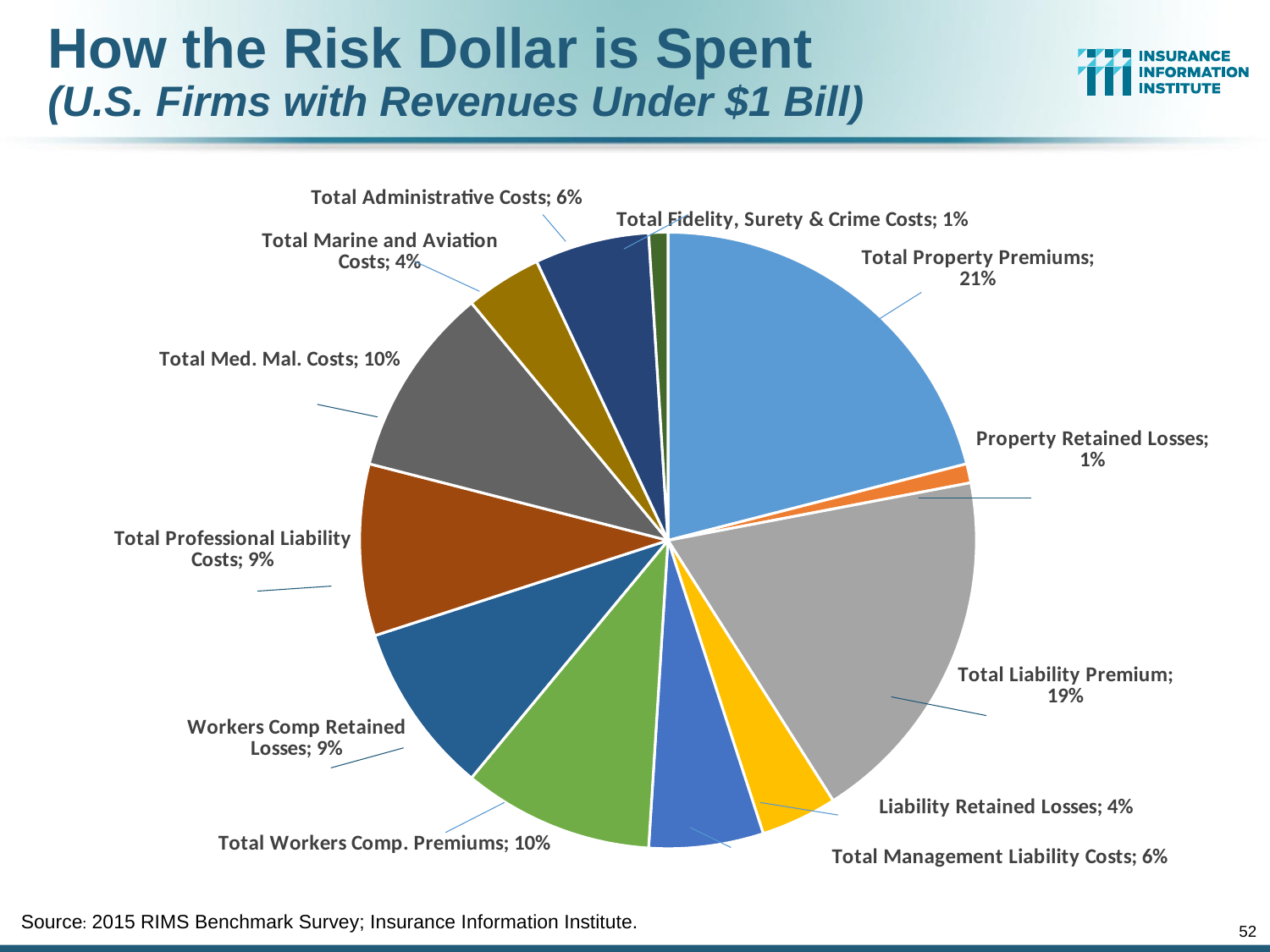
What percentage is shown for Total Marine and Aviation Costs? 4% How many slices does the pie chart have? 12 Which category has the largest share of the risk dollar? Total Property Premiums What is the title of the chart on the slide? How the Risk Dollar is Spent (U.S. Firms with Revenues Under $1 Bill) Which is larger, Total Workers Comp. Premiums or Workers Comp Retained Losses? Total Workers Comp. Premiums What kind of chart is shown on the slide? pie chart What is the difference in percentage points between Total Property Premiums and Total Liability Premium? 2 What is the combined share of Total Administrative Costs and Total Management Liability Costs? 12% What share of the risk dollar goes to Total Liability Premium? 19% What percentage is shown for Total Med. Mal. Costs? 10% What share of the risk dollar goes to Total Property Premiums? 21% What percentage is shown for Total Fidelity, Surety & Crime Costs? 1%